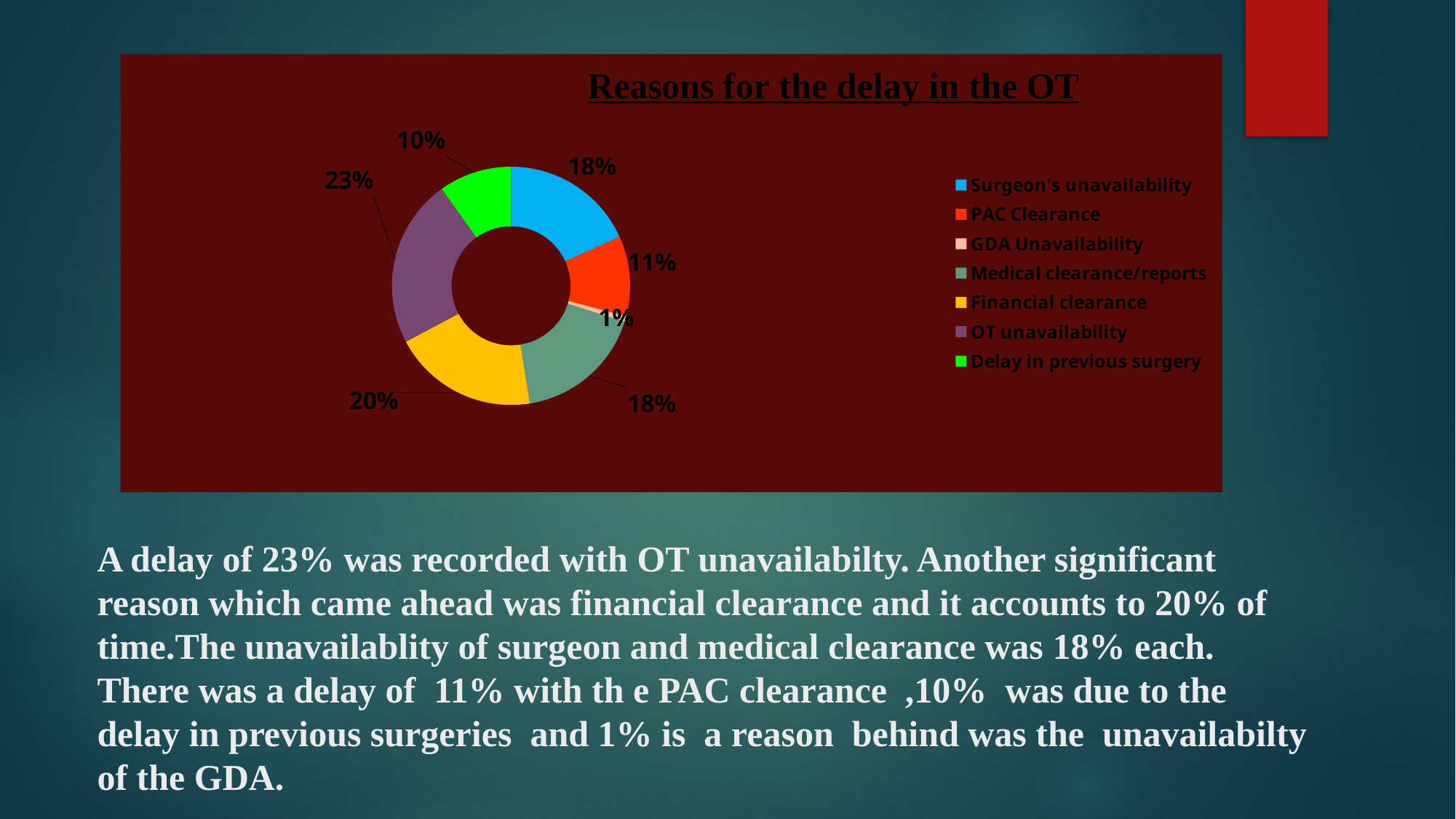
What is the difference between the shares for OT unavailability and Financial clearance? 3% Which is larger, the share for PAC Clearance or the share for Delay in previous surgery? PAC Clearance What kind of chart is shown on the slide? Doughnut chart What is the value for Delay in previous surgery? 10% What percentage of delays is attributed to OT unavailability? 23% Which reason for delay has the largest share? OT unavailability What is the value shown for PAC Clearance? 11% Which reason for delay has the smallest share? GDA Unavailability What percentage is shown for GDA Unavailability? 1% What is the title of the chart? Reasons for the delay in the OT What share of the chart does Financial clearance account for? 20% How many categories does the legend list? 7